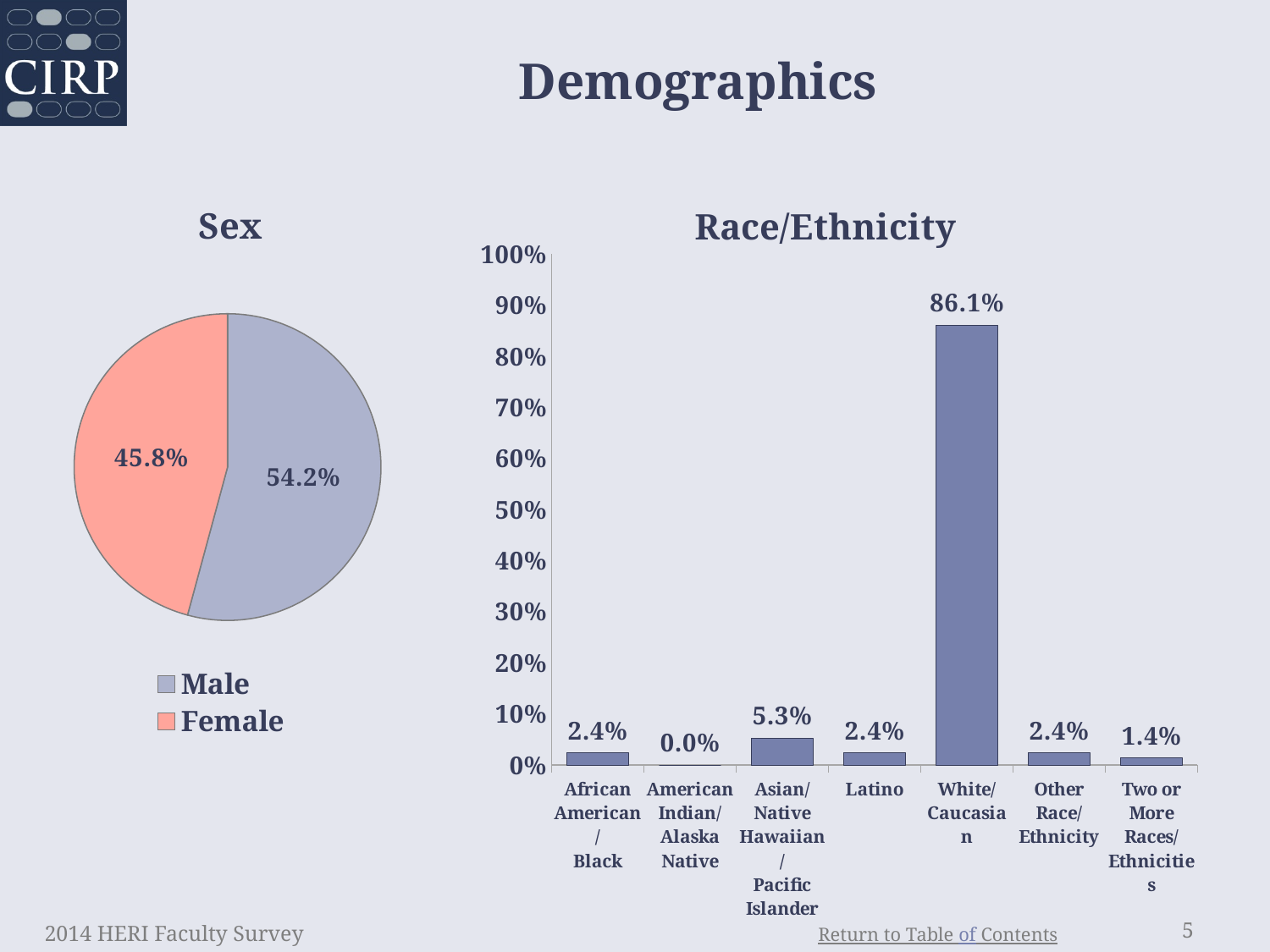
In the Race/Ethnicity chart, what is the value for White/Caucasian? 86.1% In the Race/Ethnicity chart, how many categories are shown? 7 In the Race/Ethnicity chart, which category has the lowest value? American Indian/Alaska Native In the Sex pie chart, what is the difference between the Male and Female percentages? 8.4% What kind of chart is the Sex chart? Pie chart In the Race/Ethnicity chart, what is the value for Asian/Native Hawaiian/Pacific Islander? 5.3% In the Sex pie chart, what percentage is Female? 45.8% In the Sex pie chart, which slice is larger, Male or Female? Male In the Race/Ethnicity chart, what is the difference between White/Caucasian and Asian/Native Hawaiian/Pacific Islander? 80.8% In the Sex pie chart, what percentage is Male? 54.2% In the Race/Ethnicity chart, which category has the highest value? White/Caucasian What kind of chart is the Race/Ethnicity chart? Bar chart